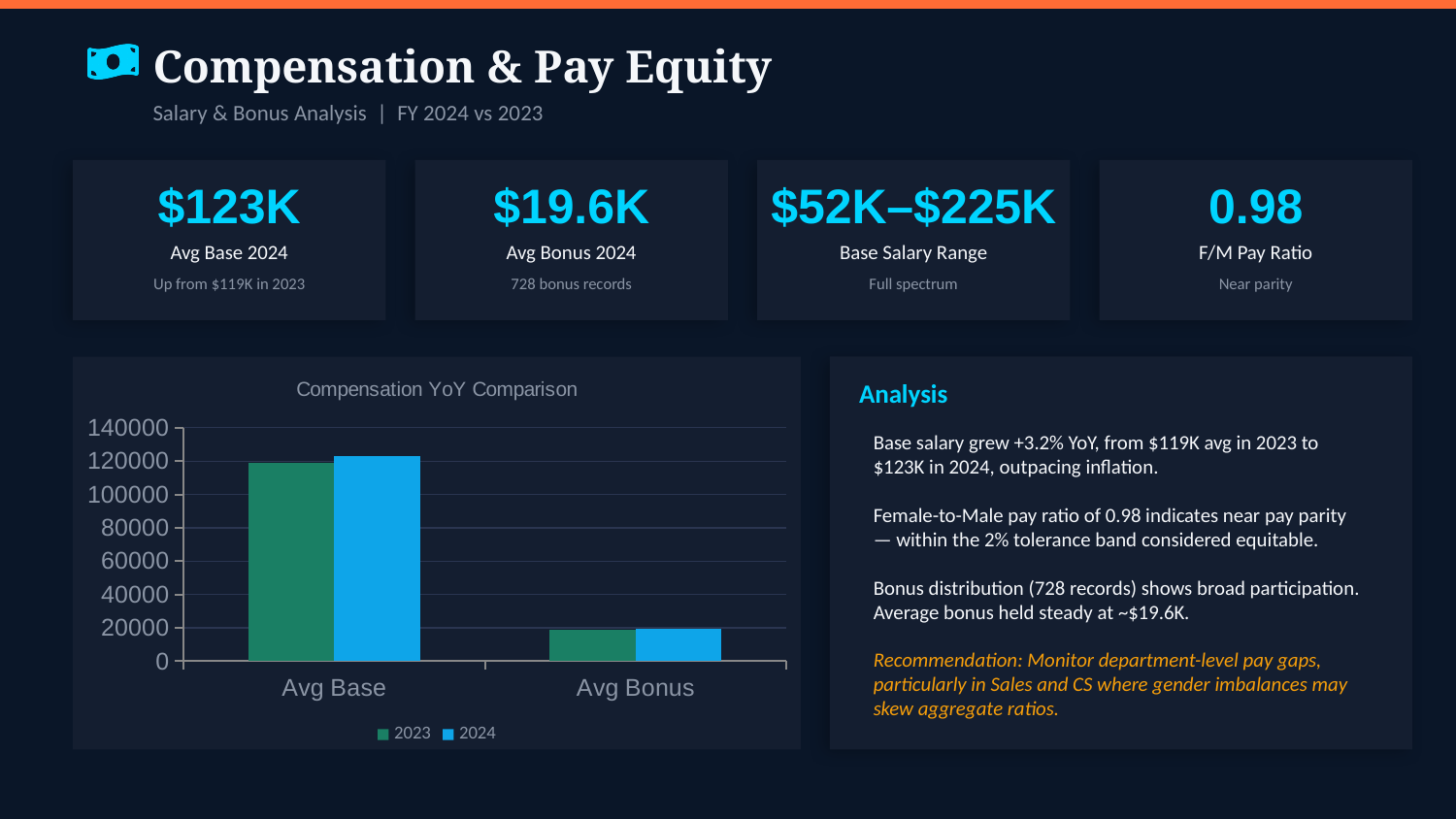
Which category has the highest bars in the chart? Avg Base How many categories are shown on the x axis of the chart? 2 Which series is shown in blue in the chart's legend? 2024 How many series does the chart's legend list? 2 Is the 2024 value for Avg Base greater or less than 140000? less Is the 2024 value for Avg Bonus greater or less than 40000? less What is the title of the chart on the slide? Compensation YoY Comparison Which is larger in the chart: the 2024 value for Avg Base or the 2024 value for Avg Bonus? Avg Base What type of chart is shown on the slide? bar chart Is the 2023 value for Avg Base greater or less than 100000? greater Which category has the lowest bars in the chart? Avg Bonus